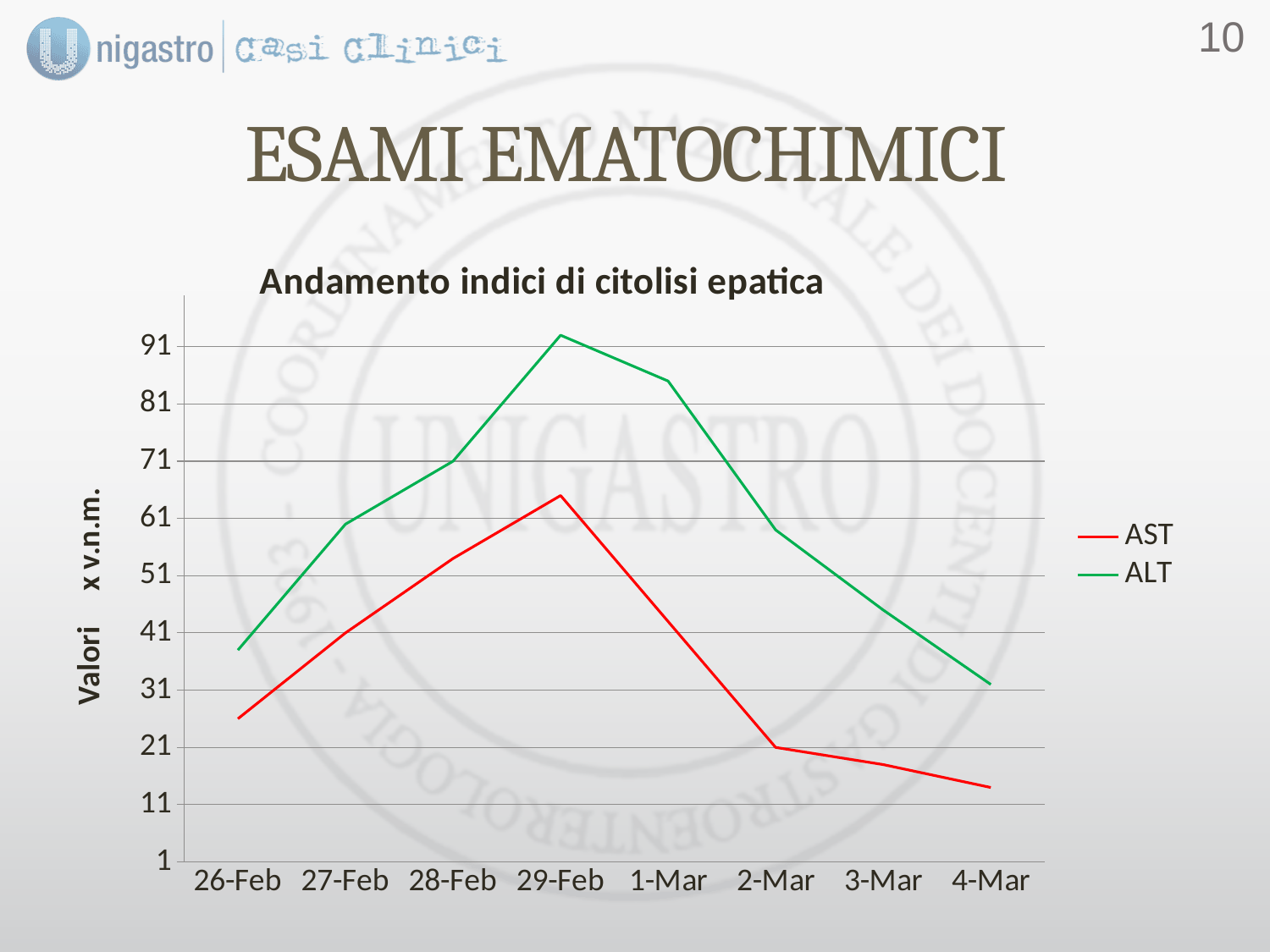
Is the AST value on 26-Feb greater or less than 31? less What is the title of the chart? Andamento indici di citolisi epatica On which date does the ALT series reach its highest value? 29-Feb How many series does the legend list? 2 On which date is the ALT value lowest? 4-Mar What kind of chart is shown on the slide? line chart Is the ALT value on 1-Mar greater or less than 81? greater On which date is the AST value lowest? 4-Mar How many dates are plotted along the x axis? 8 On 29-Feb, which series has the larger value, AST or ALT? ALT Do the AST values rise or fall from 29-Feb to 4-Mar? fall On which date does the AST series reach its highest value? 29-Feb